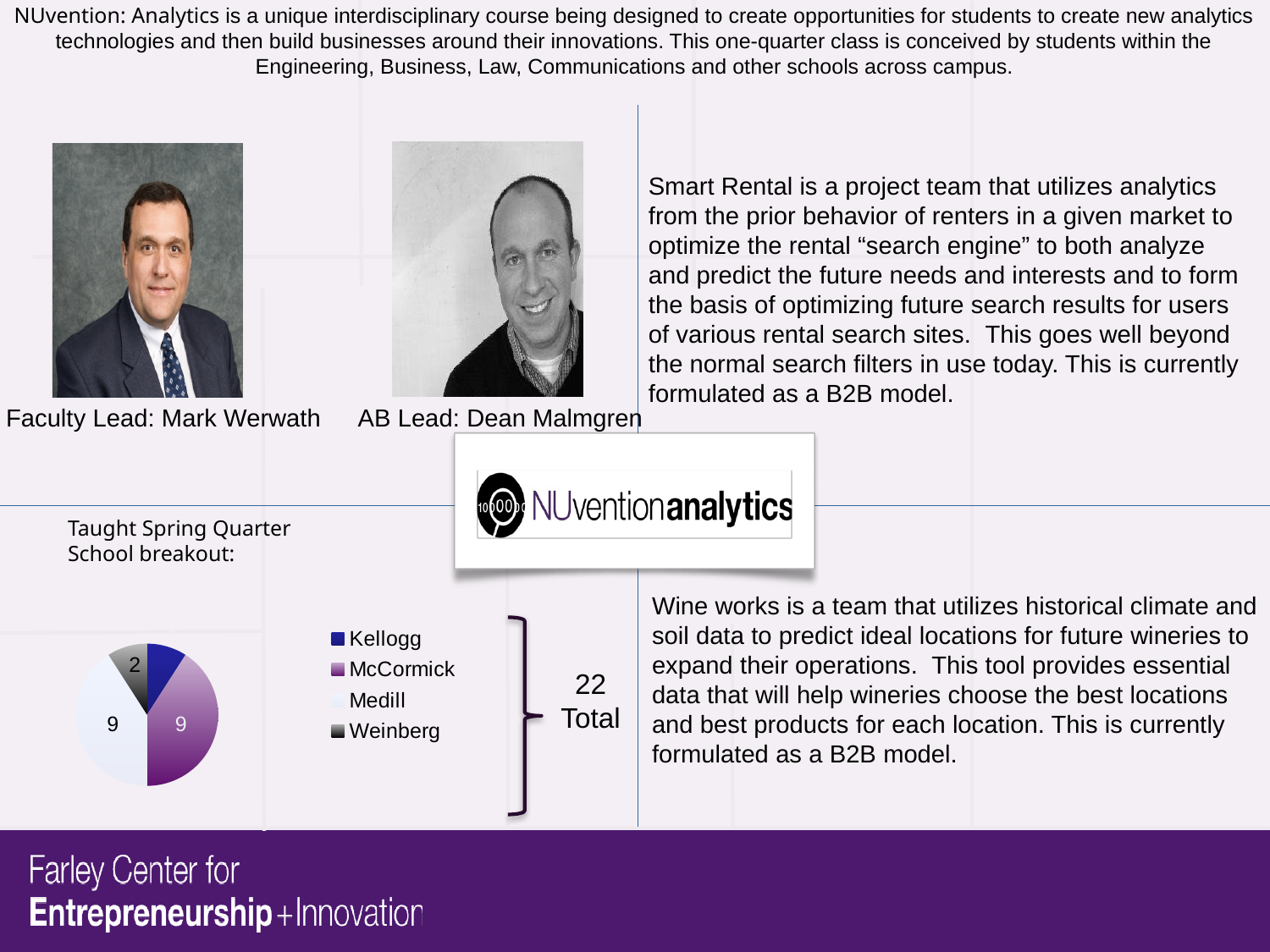
What is the value for McCormick in the pie chart? 9 Which school is shown in blue in the pie chart legend? Kellogg Which is larger in the pie chart, Kellogg or Medill? Medill What total is shown next to the pie chart? 22 Total How many schools does the legend of the pie chart list? 4 What is the difference between the McCormick and Weinberg values in the pie chart? 7 What is the value for Medill in the pie chart? 9 What heading is written above the pie chart? Taught Spring Quarter School breakout: What is the value for Weinberg in the pie chart? 2 Which is larger in the pie chart, McCormick or Weinberg? McCormick What kind of chart is shown on the slide? pie chart